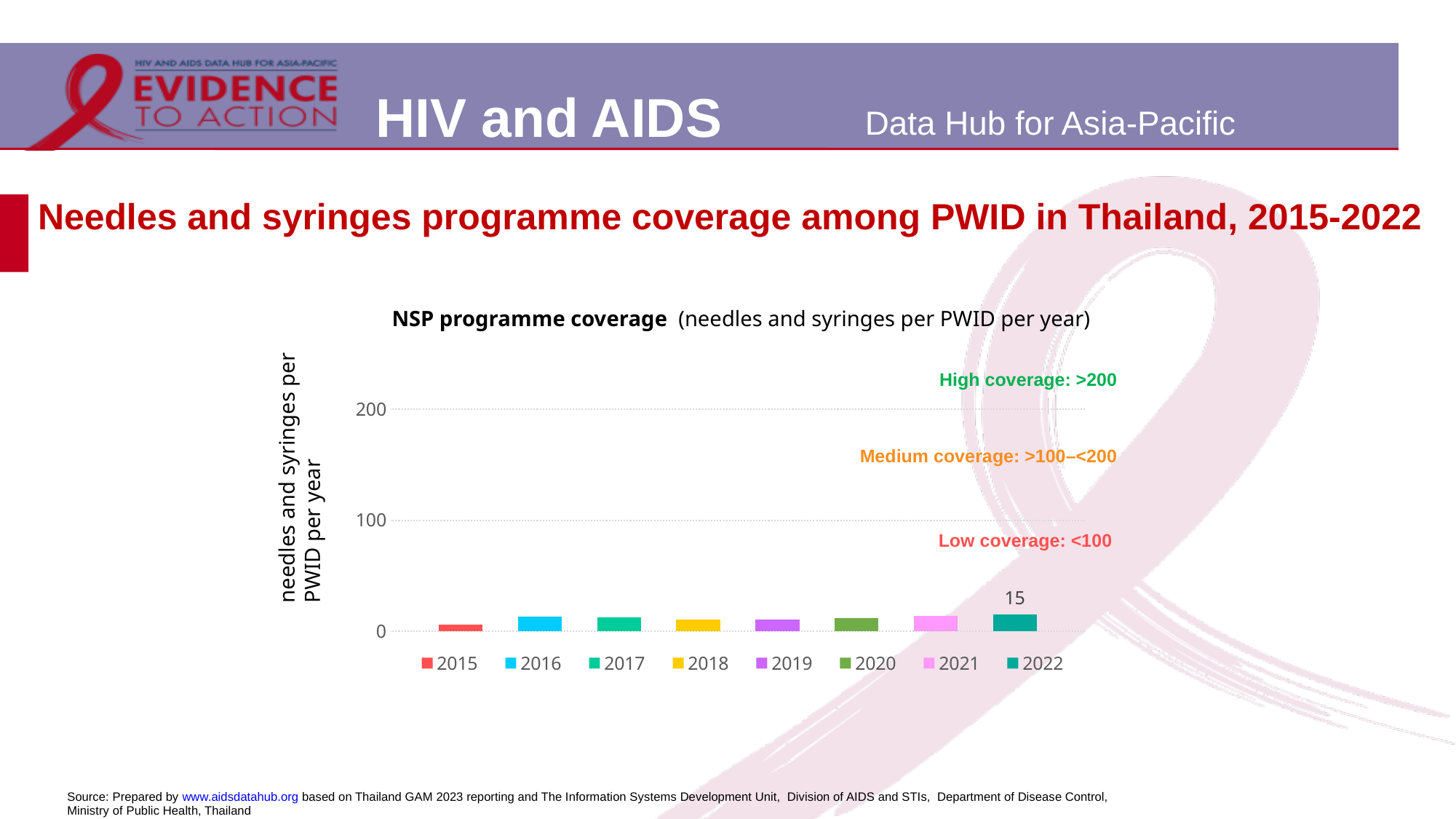
According to the chart annotation, what level of coverage is classed as 'Low coverage'? <100 What is the value for 2022 in the NSP programme coverage chart? 15 Is the value for 2015 greater or less than 100? less Is the value for 2022 greater or less than 200? less What is the title of the chart? NSP programme coverage (needles and syringes per PWID per year) Is the value for 2018 greater or less than 100? less How many bars are plotted in the NSP programme coverage chart? 8 What kind of chart is used to show NSP programme coverage? Bar chart How many series does the legend list in the NSP programme coverage chart? 8